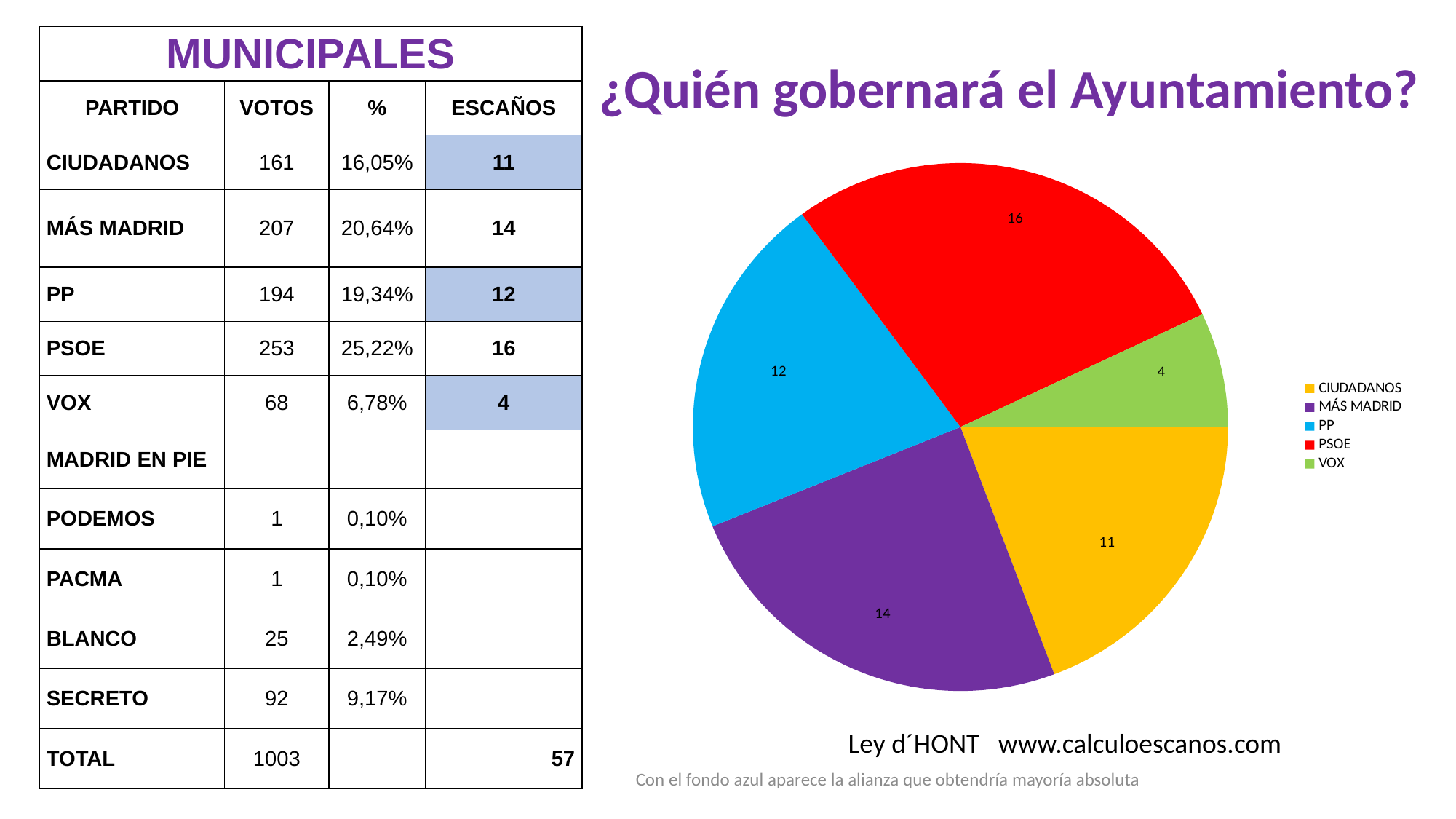
In the pie chart, which is larger, the value for PP or the value for CIUDADANOS? PP In the pie chart, what value is shown for MÁS MADRID? 14 How many entries does the pie chart's legend list? 5 In the pie chart, what value is shown for CIUDADANOS? 11 In the pie chart, what value is shown for PSOE? 16 How many slices does the pie chart have? 5 Which party has the smallest slice in the pie chart? VOX In the pie chart, what value is shown for VOX? 4 In the pie chart, what is the difference between the values for PSOE and VOX? 12 What colour is the PP slice in the pie chart? blue Which party has the largest slice in the pie chart? PSOE What kind of chart is shown on the slide? pie chart